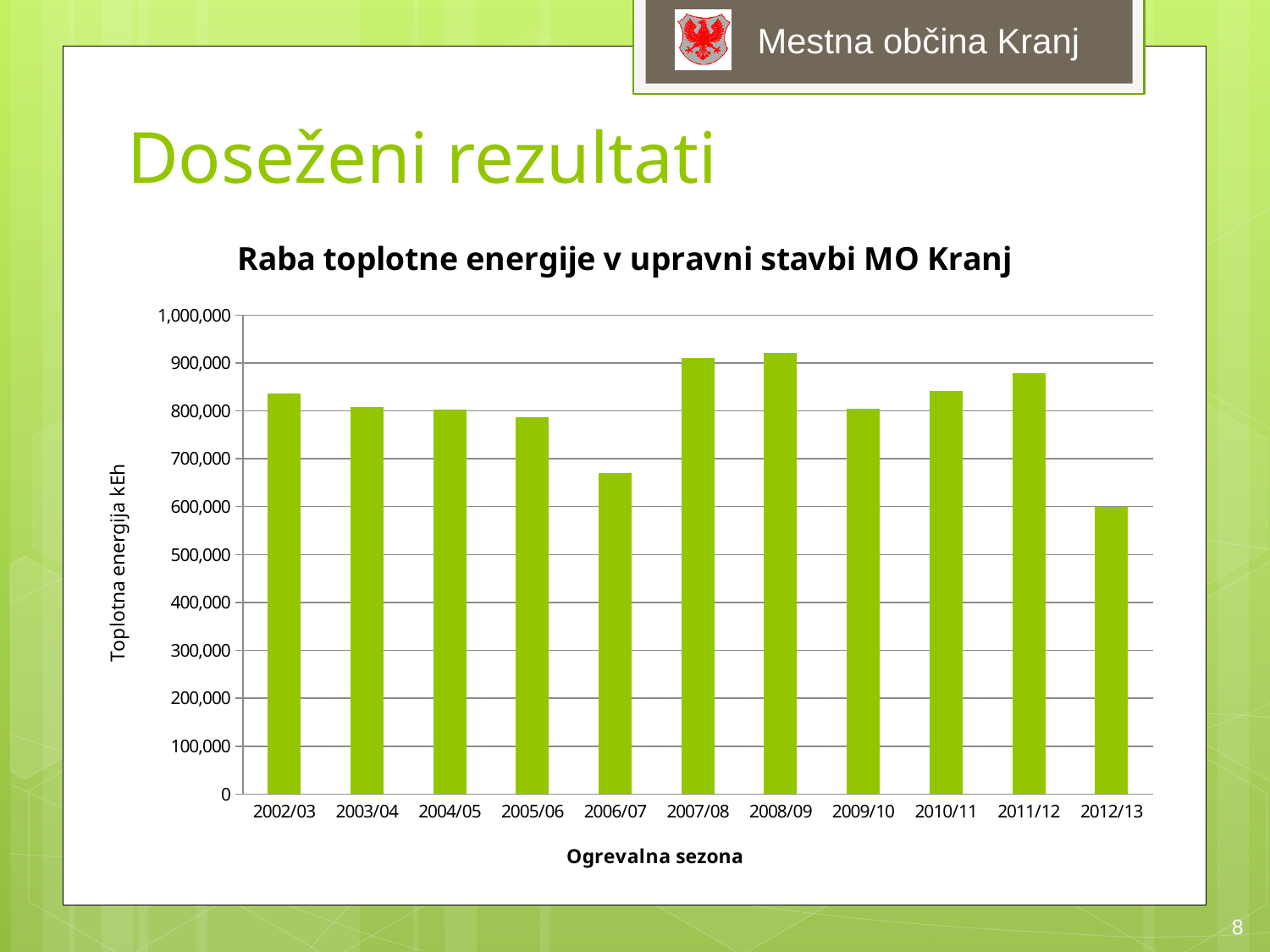
What kind of chart is shown on the slide? bar chart Which is larger, the value for 2006/07 or the value for 2012/13? 2006/07 Is the value for 2002/03 greater or less than 800,000? greater Is the value for 2007/08 greater or less than 900,000? greater Is the value for 2011/12 greater or less than 900,000? less Which is larger, the value for 2011/12 or the value for 2010/11? 2011/12 What is the title of the chart? Raba toplotne energije v upravni stavbi MO Kranj How many heating seasons (categories) are shown on the x axis? 11 What is the label of the x axis? Ogrevalna sezona Which heating season has the lowest heat energy consumption? 2012/13